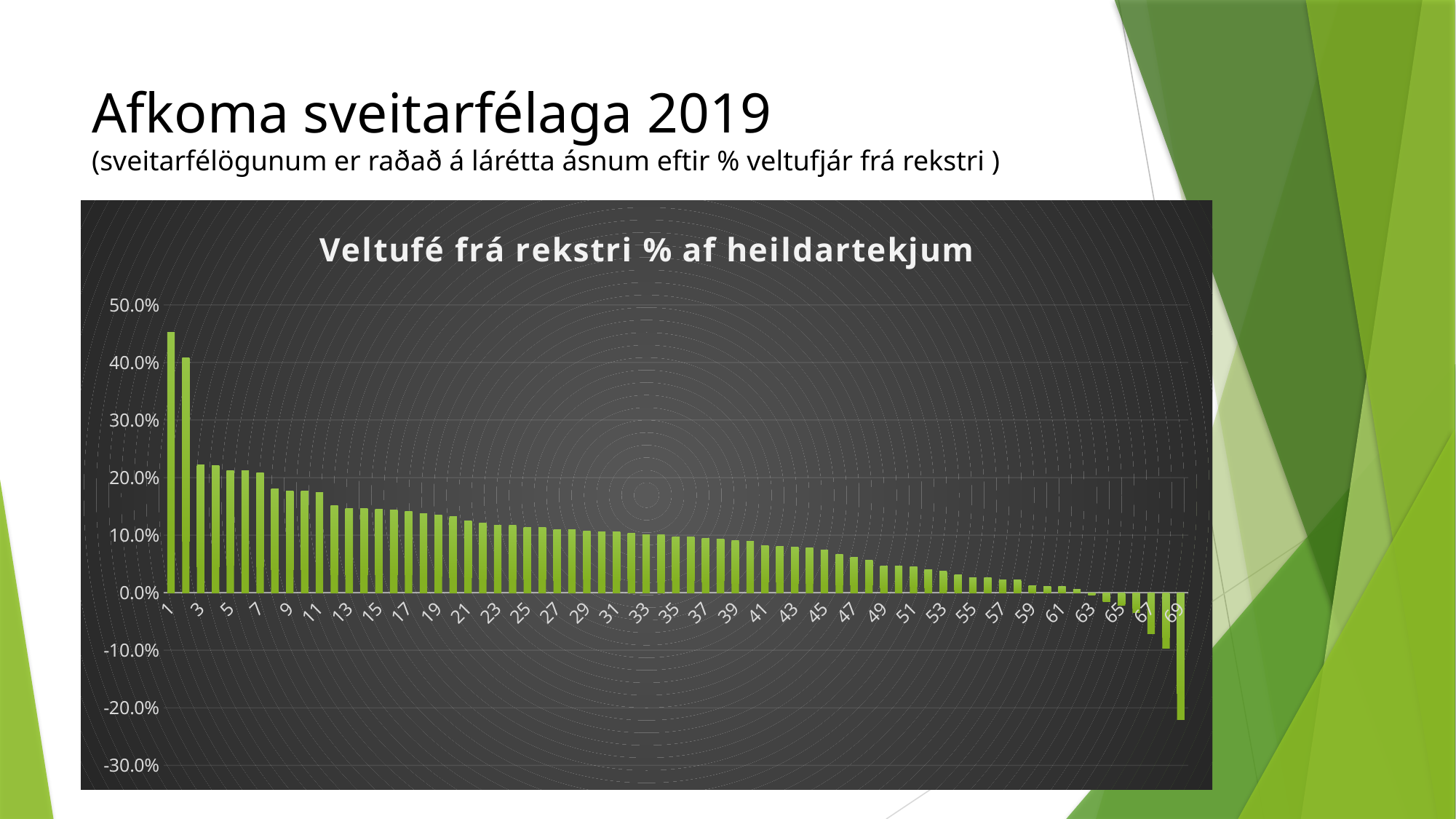
What is the lowest tick value shown on the vertical axis? -30.0% What is the title of the chart? Veltufé frá rekstri % af heildartekjum Which category on the x axis has the highest value? 1 Is the value for category 21 greater or less than 10%? greater Is the value for category 57 greater or less than 10%? less Do the values rise or fall moving from left to right along the x axis? fall Is the value for category 1 greater or less than 50%? less Which has the larger value, category 11 or category 51? 11 What kind of chart is shown on the slide? bar chart